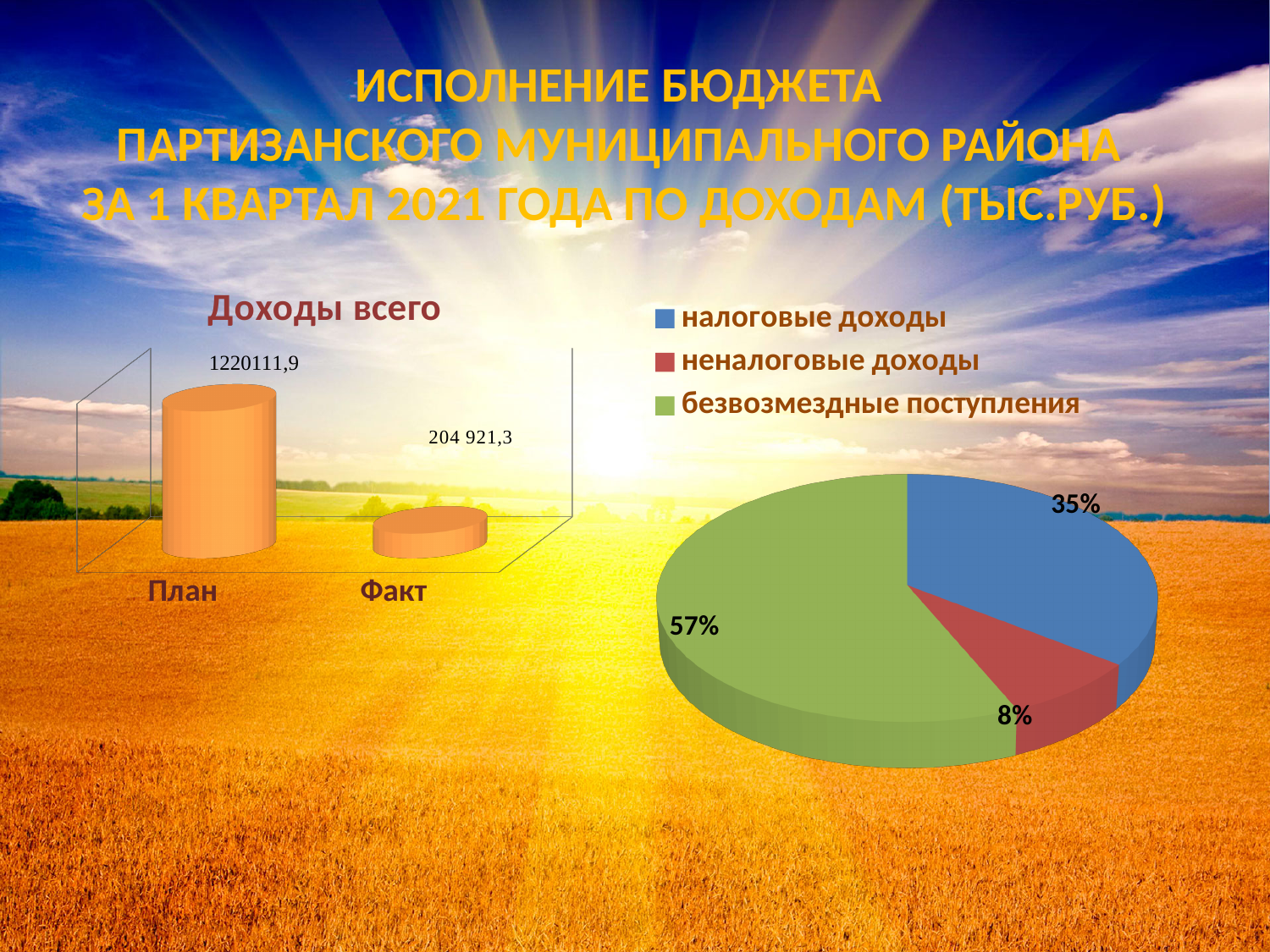
In the pie chart on the right, what share is неналоговые доходы? 8% In the 'Доходы всего' chart, which category has the higher value, План or Факт? План How many entries does the legend of the pie chart on the right list? 3 What type of chart is the 'Доходы всего' chart on the left? Bar chart In the 'Доходы всего' chart, which category has the lowest value? Факт In the 'Доходы всего' chart, what is the value for План? 1220111,9 How many categories are shown in the 'Доходы всего' chart? 2 In the pie chart on the right, what is the difference in percentage points between безвозмездные поступления and налоговые доходы? 22 percentage points In the pie chart on the right, what share is налоговые доходы? 35% In the pie chart on the right, which category has the largest share? безвозмездные поступления In the pie chart on the right, what share is безвозмездные поступления? 57% In the 'Доходы всего' chart, what is the value for Факт? 204 921,3